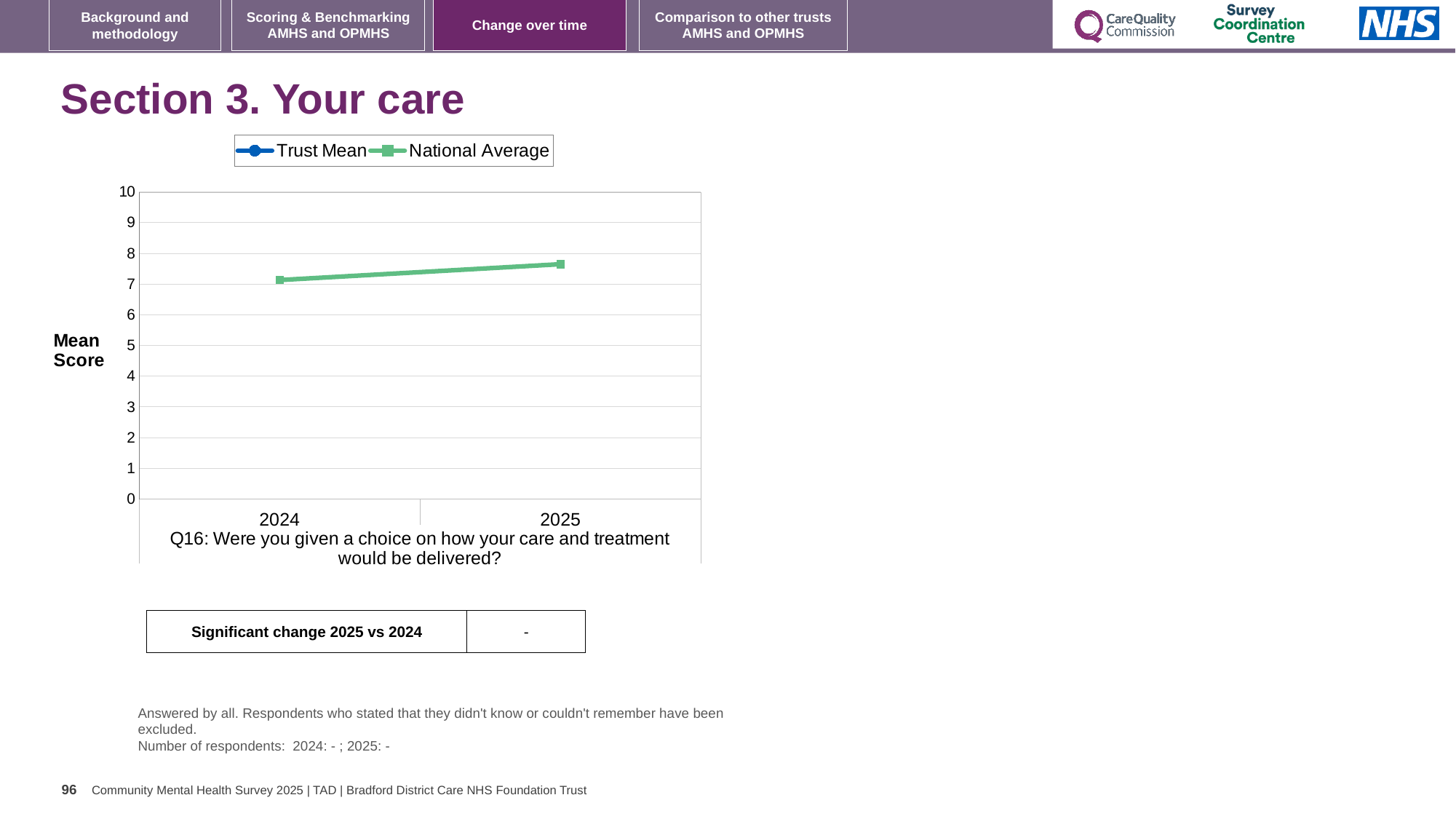
Is the National Average value for 2024 greater or less than 5? greater Is the National Average value for 2025 greater or less than 7? greater Is the National Average value for 2024 greater or less than 8? less How many years are shown on the x axis? 2 What kind of chart is shown on the slide? line chart Which year has the higher National Average value, 2024 or 2025? 2025 Does the National Average line rise or fall from 2024 to 2025? rise How many series does the legend list? 2 What is the label on the y axis of the chart? Mean Score What are the two series named in the legend? Trust Mean and National Average Which year has the lowest National Average value? 2024